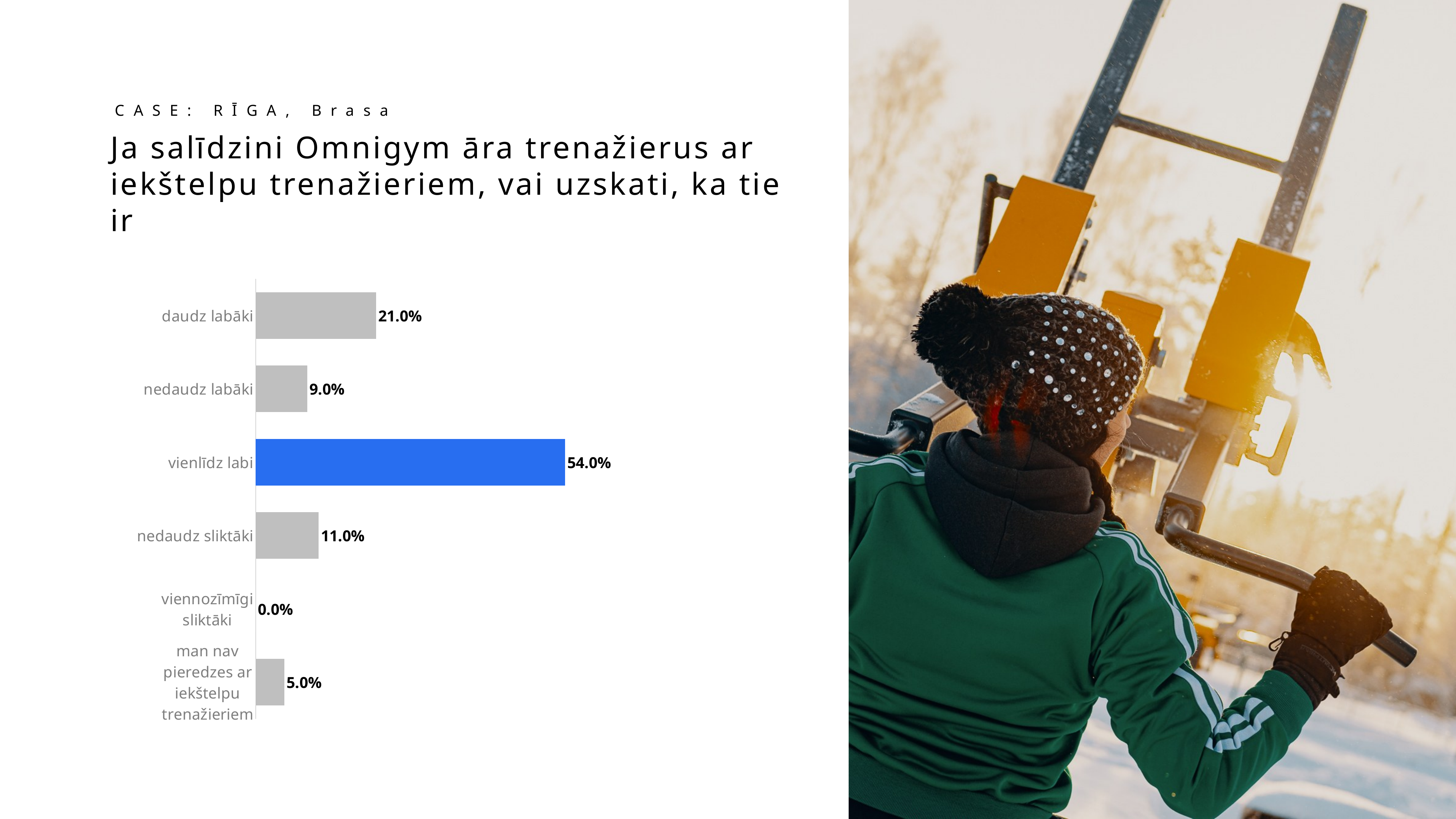
What is the value for "man nav pieredzes ar iekštelpu trenažieriem"? 5.0% What kind of chart is shown on the slide? bar chart What is the value for "daudz labāki"? 21.0% Which is larger, the value for "nedaudz labāki" or the value for "nedaudz sliktāki"? nedaudz sliktāki Which category has the lowest value? viennozīmīgi sliktāki Which category has the highest value? vienlīdz labi What is the difference between the values for "vienlīdz labi" and "daudz labāki"? 33.0% Which bar is coloured blue rather than grey? vienlīdz labi How many categories are shown in the chart? 6 What is the value for "vienlīdz labi"? 54.0% What is the value for "nedaudz sliktāki"? 11.0% What is the difference between the values for "nedaudz labāki" and "man nav pieredzes ar iekštelpu trenažieriem"? 4.0%